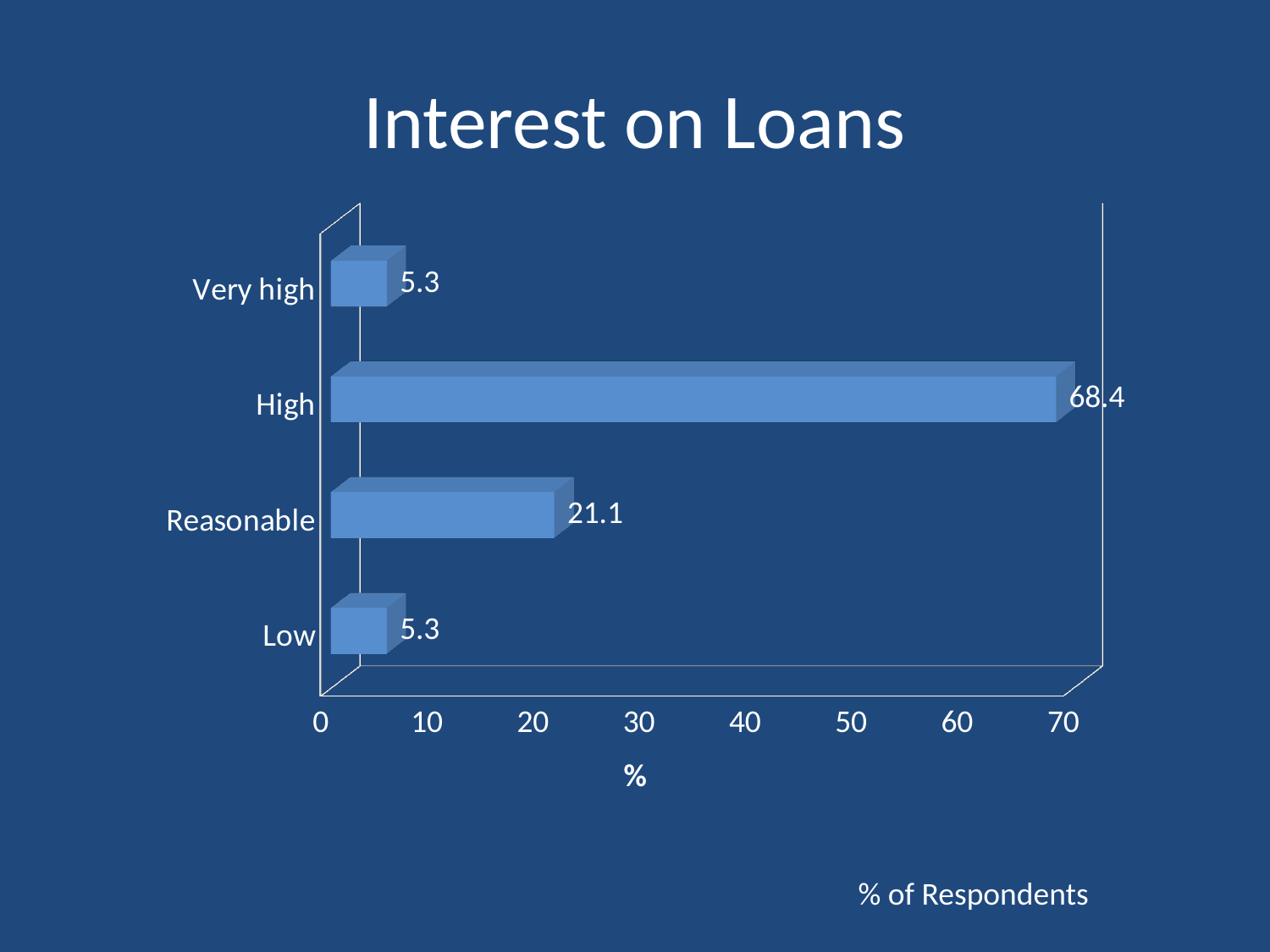
Is the value for High greater or less than 60? greater What is the title of the chart? Interest on Loans What is the value for High? 68.4 What is the difference between the values for Reasonable and Low? 15.8 What is the difference between the values for High and Reasonable? 47.3 What kind of chart is shown on the slide? bar chart What is the value for Very high? 5.3 What is the value for Low? 5.3 Which category has the highest value? High What is the value for Reasonable? 21.1 How many categories are shown in the chart? 4 Which is larger, the value for Reasonable or the value for Very high? Reasonable